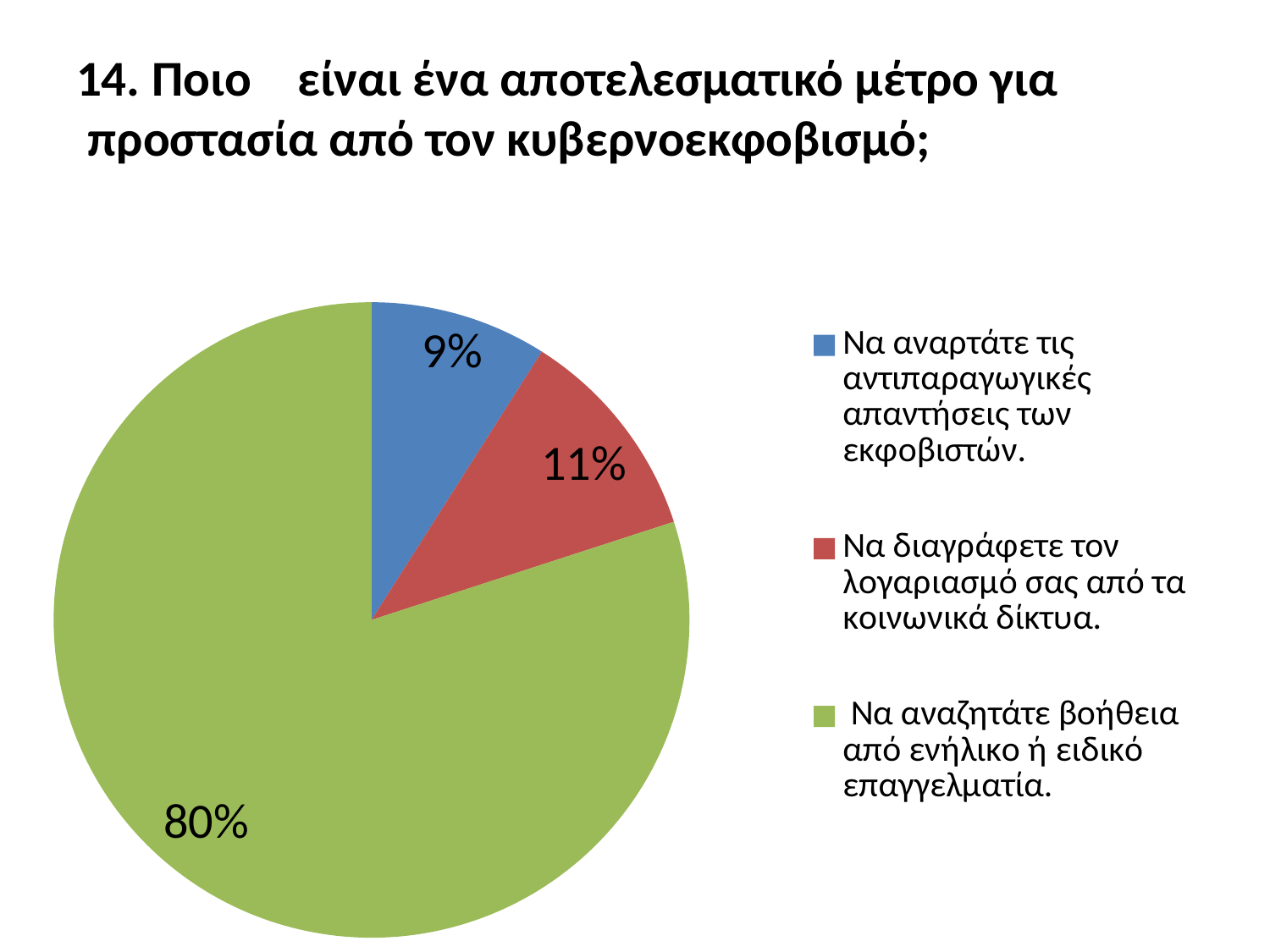
Which is larger: the slice for "Να διαγράφετε τον λογαριασμό σας από τα κοινωνικά δίκτυα." or the slice for "Να αναρτάτε τις αντιπαραγωγικές απαντήσεις των εκφοβιστών."? Να διαγράφετε τον λογαριασμό σας από τα κοινωνικά δίκτυα. What share of the pie does "Να διαγράφετε τον λογαριασμό σας από τα κοινωνικά δίκτυα." have? 11% What is the difference in percentage points between the 11% slice and the 9% slice? 2 What is the difference in percentage points between the largest slice (80%) and the slice for "Να διαγράφετε τον λογαριασμό σας από τα κοινωνικά δίκτυα."? 69 What share of the pie does "Να αναρτάτε τις αντιπαραγωγικές απαντήσεις των εκφοβιστών." have? 9% Which category has the smallest slice of the pie? Να αναρτάτε τις αντιπαραγωγικές απαντήσεις των εκφοβιστών. What share of the pie does "Να αναζητάτε βοήθεια από ενήλικο ή ειδικό επαγγελματία." have? 80% What kind of chart is shown on the slide? pie chart Which category has the largest slice of the pie? Να αναζητάτε βοήθεια από ενήλικο ή ειδικό επαγγελματία. How many slices does the pie chart have? 3 What colour is the slice labelled 80%? green Which category is shown in blue in the legend? Να αναρτάτε τις αντιπαραγωγικές απαντήσεις των εκφοβιστών.